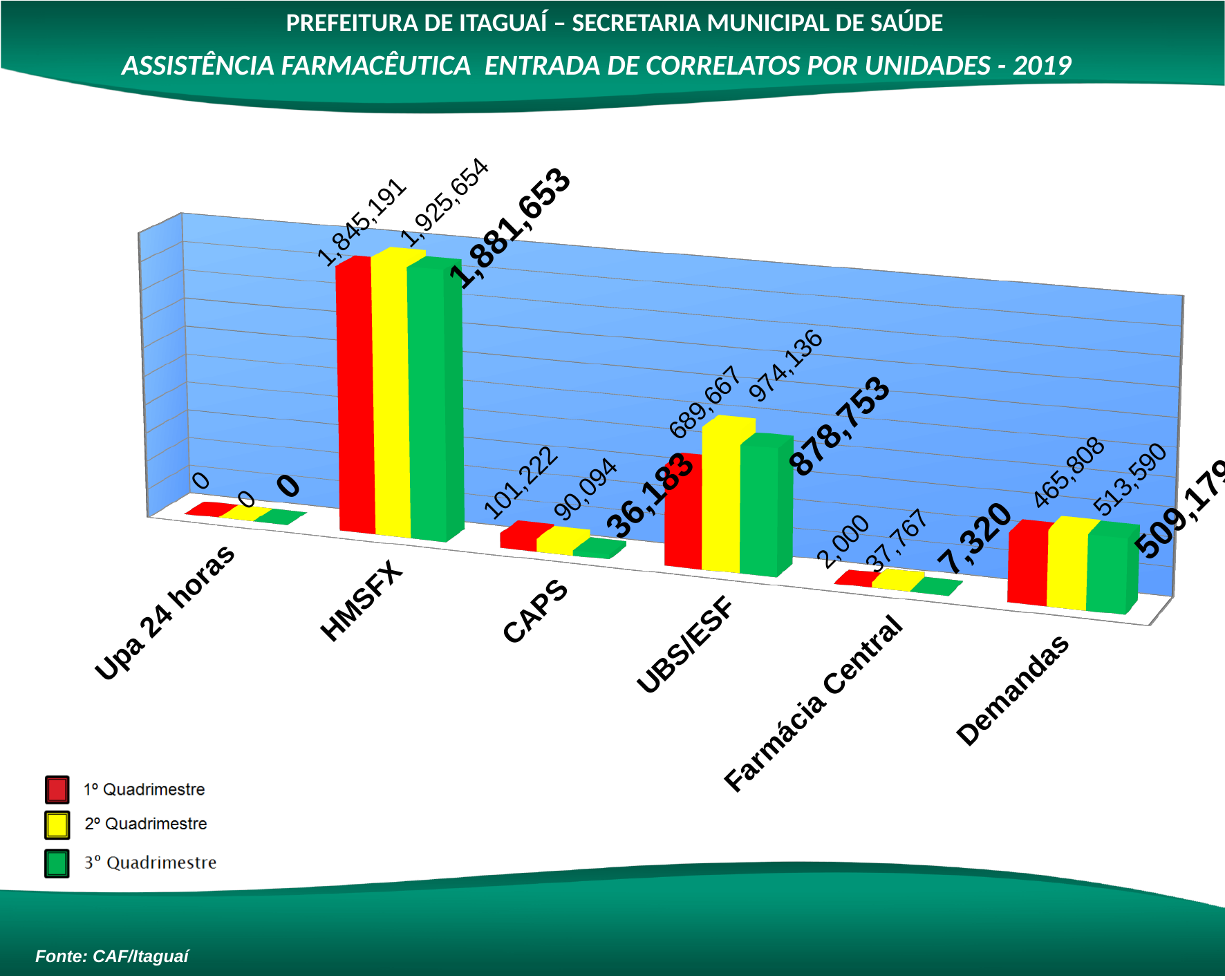
How many categories are shown on the x axis? 6 What is the value for Demandas in the 3º Quadrimestre series? 509,179 Which colour represents the 2º Quadrimestre series in the legend? Yellow Which category has the highest value in the 2º Quadrimestre series? HMSFX What is the value for Farmácia Central in the 1º Quadrimestre series? 2,000 Which is larger for CAPS: the 1º Quadrimestre value or the 3º Quadrimestre value? 1º Quadrimestre What is the value for UBS/ESF in the 1º Quadrimestre series? 689,667 What is the value for HMSFX in the 2º Quadrimestre series? 1,925,654 How many series does the legend list? 3 What is the difference between the 2º Quadrimestre and 1º Quadrimestre values for UBS/ESF? 284,469 Which category has the lowest value in the 1º Quadrimestre series? Upa 24 horas What kind of chart is shown on the slide? Bar chart